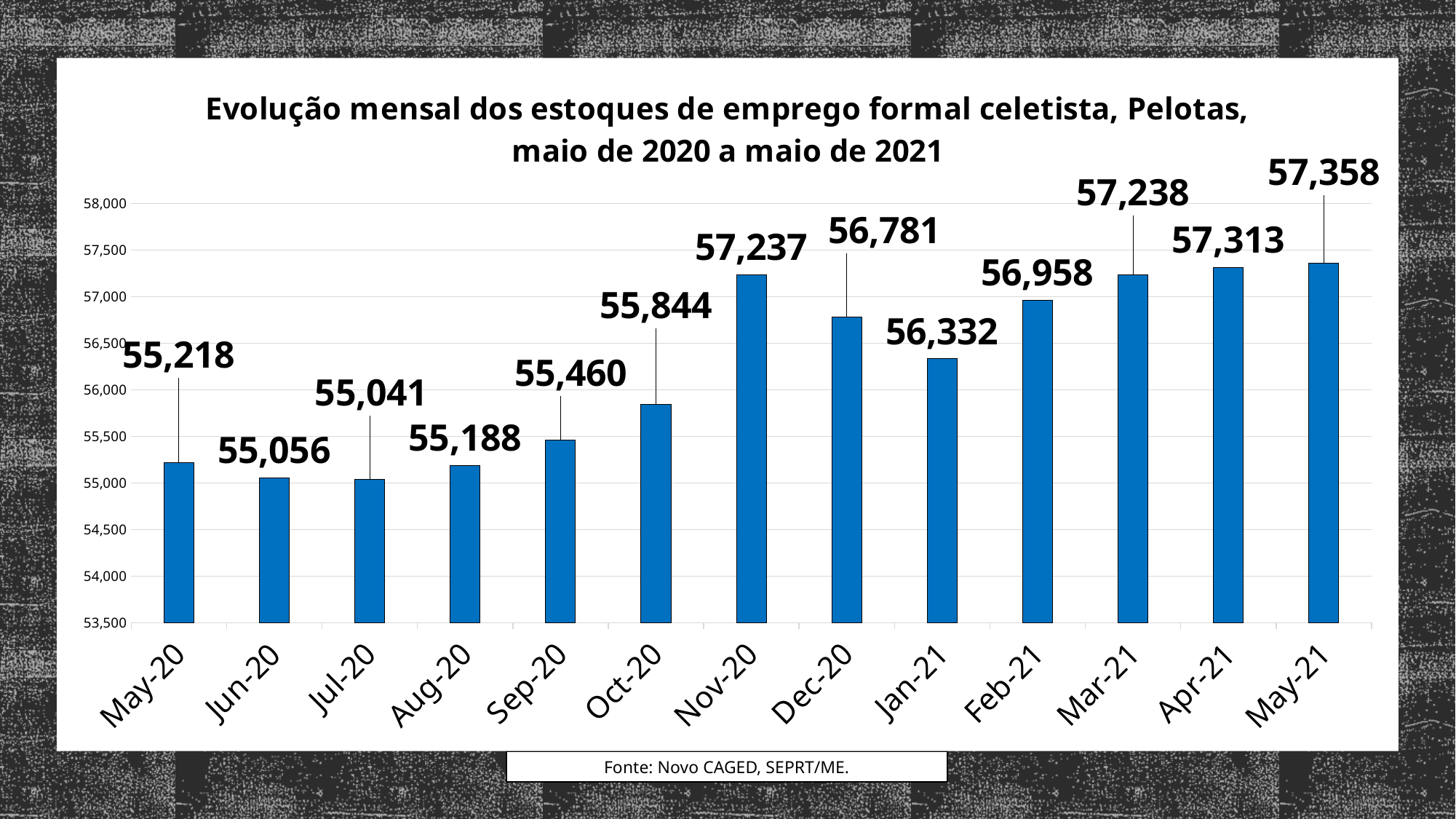
Is the value for Oct-20 greater or less than 56,000? less What is the difference between the values for Nov-20 and Oct-20? 1,393 Which month has the highest value? May-21 Which is larger, the value for Dec-20 or the value for Feb-21? Feb-21 What is the value for Jan-21? 56,332 What kind of chart is shown on the slide? bar chart Which month has the lowest value? Jul-20 What is the value for Nov-20? 57,237 What is the difference between the values for May-21 and May-20? 2,140 What is the source cited below the chart? Novo CAGED, SEPRT/ME. How many months are shown on the x axis? 13 What is the value for Aug-20? 55,188